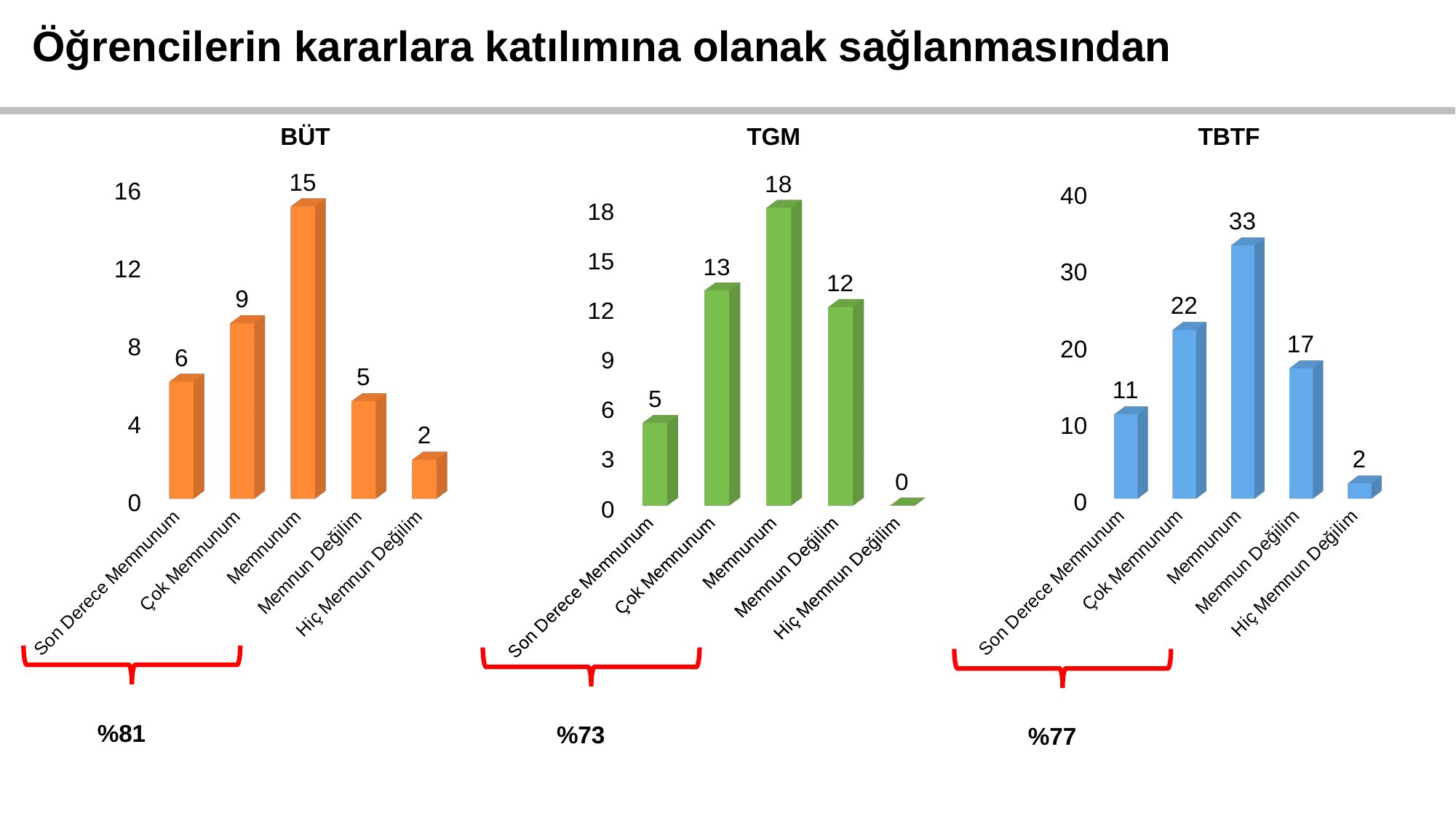
In the BÜT chart, which category has the lowest value? Hiç Memnun Değilim In the TBTF chart, which category has the highest value? Memnunum In the TGM chart, what is the value for Hiç Memnun Değilim? 0 In the TBTF chart, what is the difference between Memnunum and Memnun Değilim? 16 What percentage is shown below the TBTF chart? %77 In the TBTF chart, what is the value for Çok Memnunum? 22 How many categories does the TGM chart show? 5 What kind of chart is the BÜT chart? bar chart In the TGM chart, is the value for Memnun Değilim greater or less than 9? greater In the BÜT chart, what is the value for Memnunum? 15 In the BÜT chart, which is larger: Çok Memnunum or Memnun Değilim? Çok Memnunum In the TGM chart, what is the difference between Memnunum and Çok Memnunum? 5